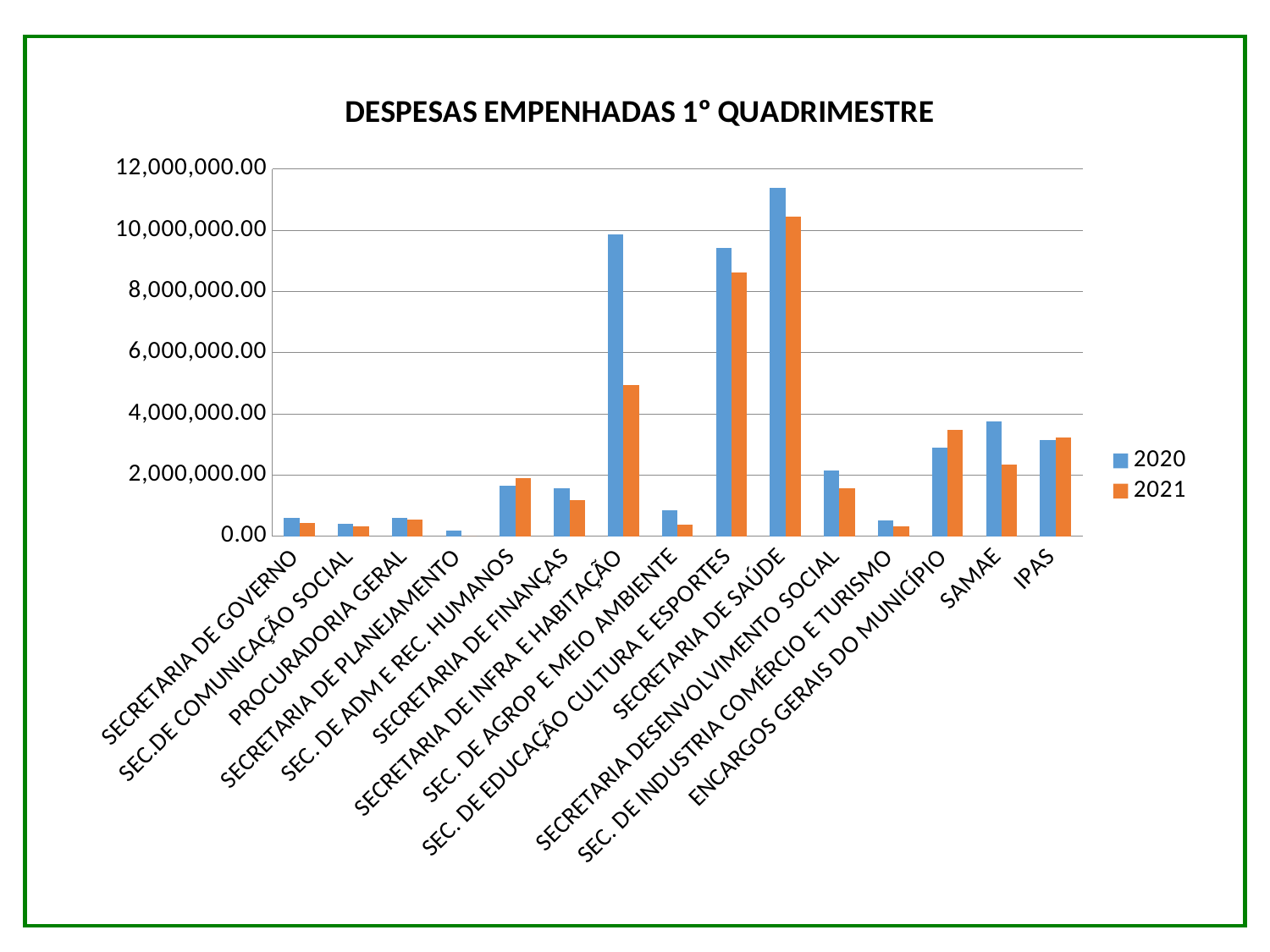
Is the 2020 value for SECRETARIA DE SAÚDE greater or less than 10,000,000.00? greater For SECRETARIA DE INFRA E HABITAÇÃO, which series has the larger value, 2020 or 2021? 2020 What is the title of the chart? DESPESAS EMPENHADAS 1° QUADRIMESTRE Is the 2021 value for SECRETARIA DE INFRA E HABITAÇÃO greater or less than 6,000,000.00? less How many series does the legend list? 2 How many categories are shown on the x axis? 15 What kind of chart is shown on the slide? bar chart For ENCARGOS GERAIS DO MUNICÍPIO, which series has the larger value, 2020 or 2021? 2021 Which category has the highest value for 2021? SECRETARIA DE SAÚDE Is the 2020 value for SEC. DE EDUCAÇÃO CULTURA E ESPORTES greater or less than 8,000,000.00? greater Which category has the highest value for 2020? SECRETARIA DE SAÚDE Which category has the lowest value for 2020? SECRETARIA DE PLANEJAMENTO